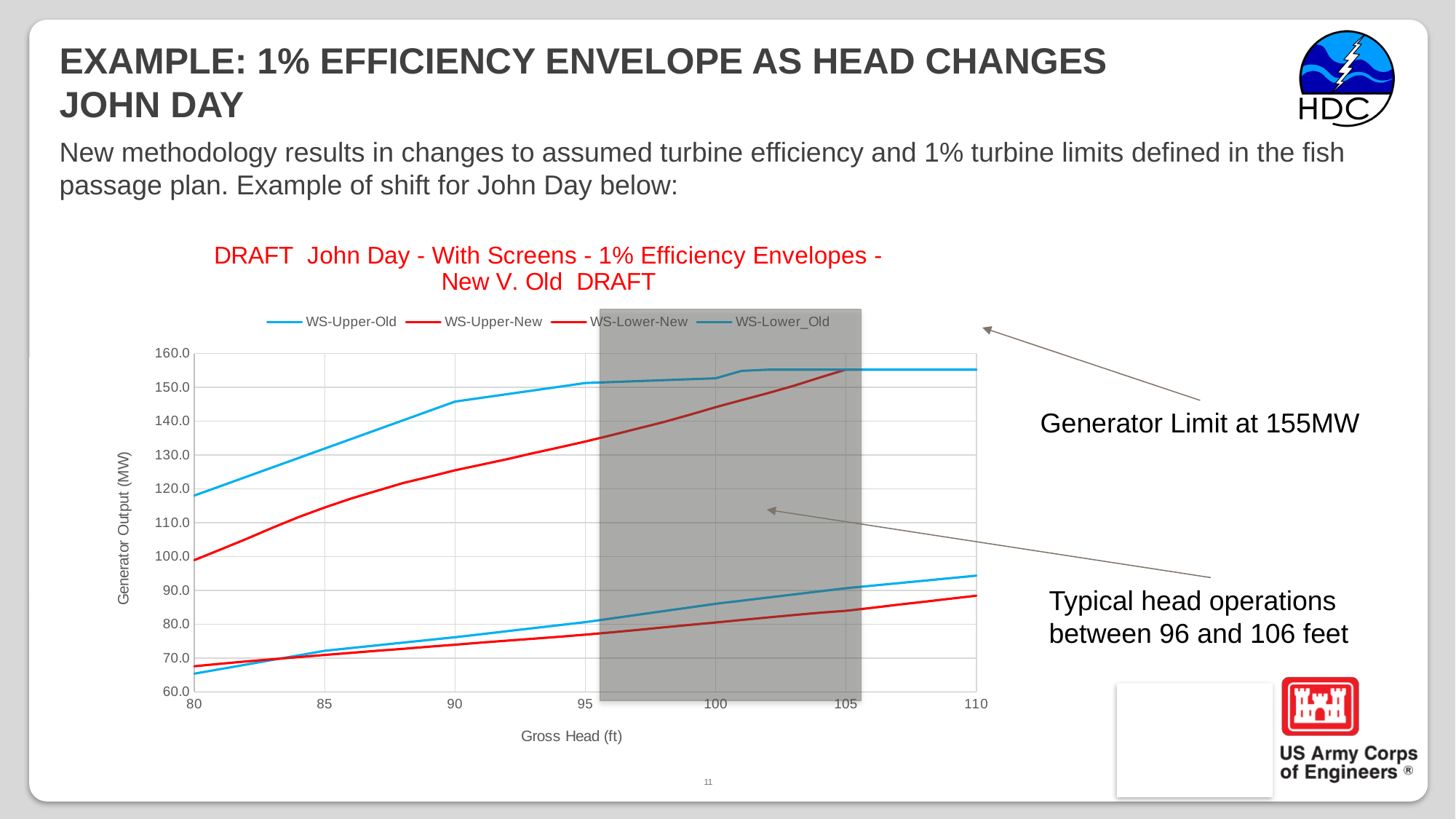
What is the label of the y axis? Generator Output (MW) What kind of chart is shown on the slide? line chart Is the value for WS-Upper-Old at a gross head of 80 ft greater or less than 110? greater What is the label of the x axis? Gross Head (ft) Does the WS-Upper-New series rise or fall as gross head increases from 80 to 105 ft? rise At a gross head of 80 ft, which is larger: WS-Upper-Old or WS-Upper-New? WS-Upper-Old How many series does the chart legend list? 4 Is the value for WS-Upper-Old at a gross head of 90 ft greater or less than 140? greater Is the value for WS-Lower-New at a gross head of 110 ft greater or less than 90? less At a gross head of 110 ft, which is larger: WS-Lower_Old or WS-Lower-New? WS-Lower_Old